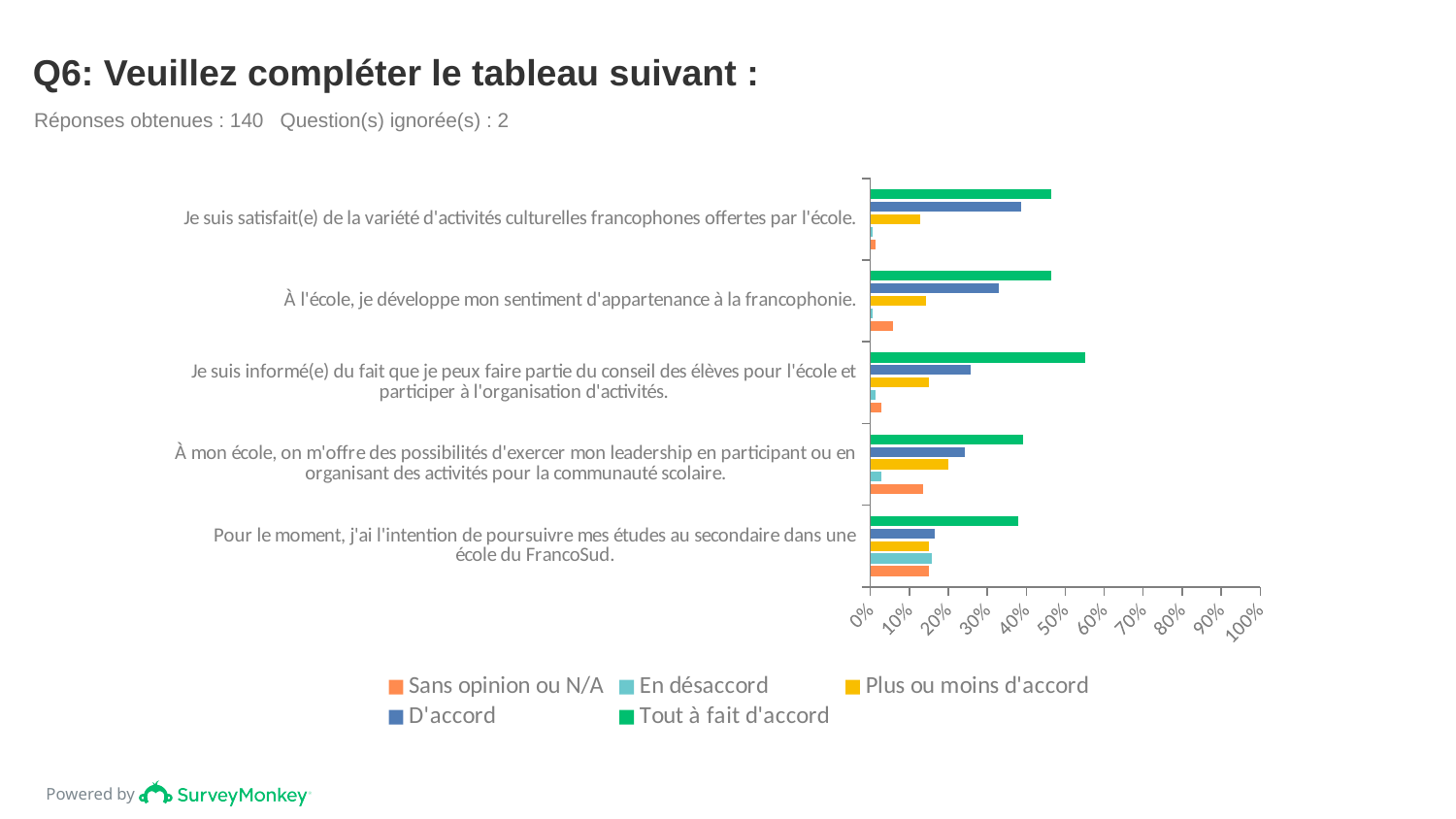
Is the 'Sans opinion ou N/A' value for 'Pour le moment, j'ai l'intention de poursuivre mes études au secondaire dans une école du FrancoSud.' greater or less than 10%? greater How many series does the legend list? 5 What kind of chart is shown on the slide? bar chart For 'Je suis satisfait(e) de la variété d'activités culturelles francophones offertes par l'école.', which is larger: 'Tout à fait d'accord' or 'D'accord'? Tout à fait d'accord Is the 'D'accord' value for 'Je suis satisfait(e) de la variété d'activités culturelles francophones offertes par l'école.' greater or less than 30%? greater Which legend entry is shown in orange? Sans opinion ou N/A Is the 'En désaccord' value for 'À l'école, je développe mon sentiment d'appartenance à la francophonie.' greater or less than 10%? less Which statement has the highest value for 'Tout à fait d'accord'? Je suis informé(e) du fait que je peux faire partie du conseil des élèves pour l'école et participer à l'organisation d'activités. How many statements (categories) are plotted on the chart? 5 For 'Pour le moment, j'ai l'intention de poursuivre mes études au secondaire dans une école du FrancoSud.', which is larger: 'D'accord' or 'Tout à fait d'accord'? Tout à fait d'accord